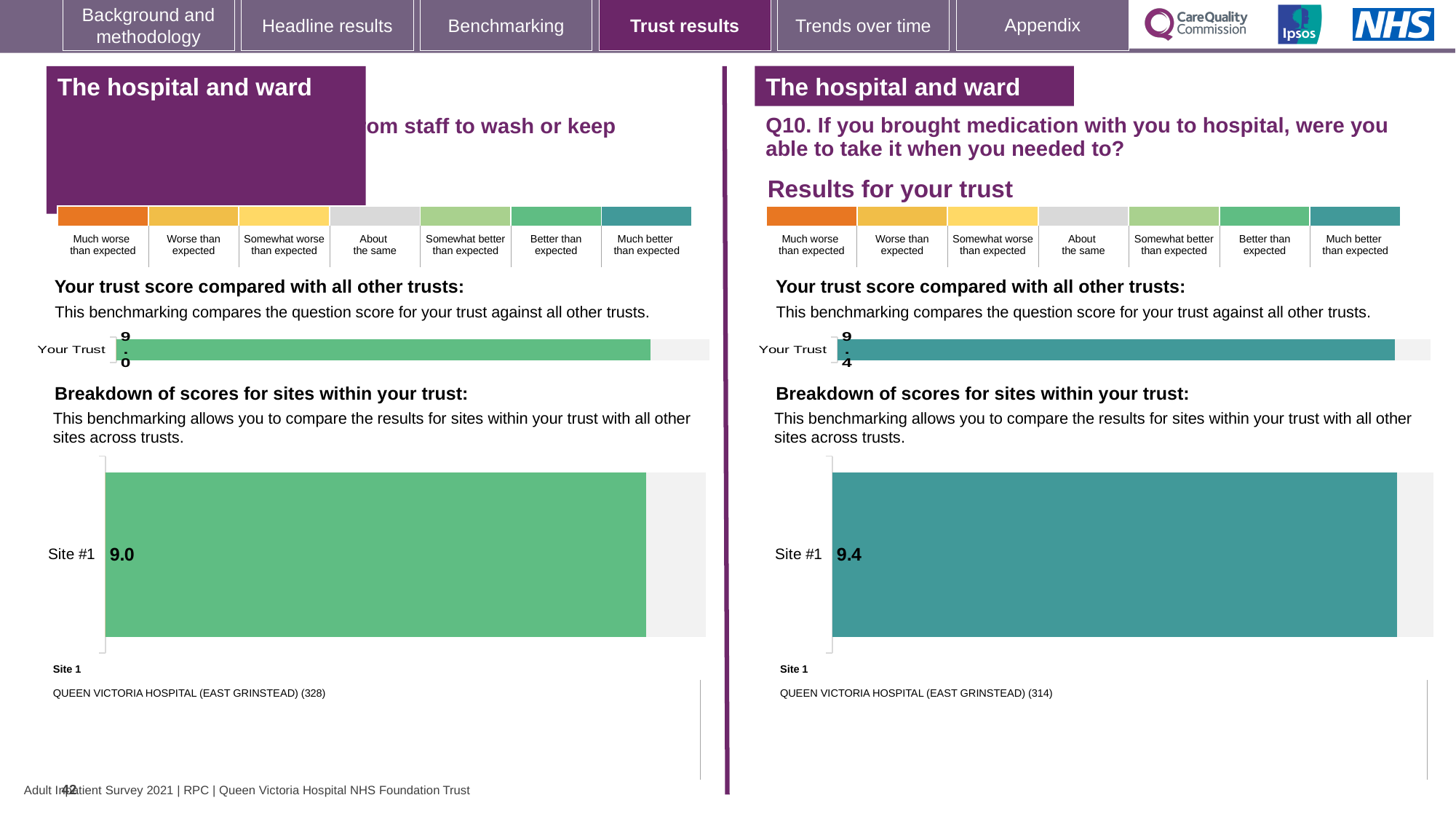
What is the question text shown above the charts on the right-hand side of the slide? Q10. If you brought medication with you to hospital, were you able to take it when you needed to? In the 'Breakdown of scores for sites within your trust' chart on the right-hand side of the slide (Q10), what is the value for Site #1? 9.4 How many sites are shown in the 'Breakdown of scores for sites within your trust' chart on the right-hand side of the slide (Q10)? 1 What kind of chart is used to show the Your Trust score on the right-hand side of the slide (Q10)? Bar chart What kind of chart is used to show the Site #1 score on the left-hand side of the slide? Bar chart Which is larger: the Site #1 score in the left-hand breakdown chart or the Site #1 score in the right-hand (Q10) breakdown chart? The right-hand (Q10) chart On the left-hand side of the slide, what is the score shown for Your Trust in the 'Your trust score compared with all other trusts' chart? 9.0 In the 'Breakdown of scores for sites within your trust' chart on the left-hand side of the slide, what is the value for Site #1? 9.0 Which site is listed as Site 1 below the breakdown chart on the right-hand side of the slide (Q10)? QUEEN VICTORIA HOSPITAL (EAST GRINSTEAD) (314) Is the Your Trust score in the left-hand 'Your trust score compared with all other trusts' chart greater or less than 5? greater What is the difference between the Site #1 score in the right-hand (Q10) breakdown chart and the Site #1 score in the left-hand breakdown chart? 0.4 On the right-hand side of the slide (Q10), what is the score shown for Your Trust in the 'Your trust score compared with all other trusts' chart? 9.4